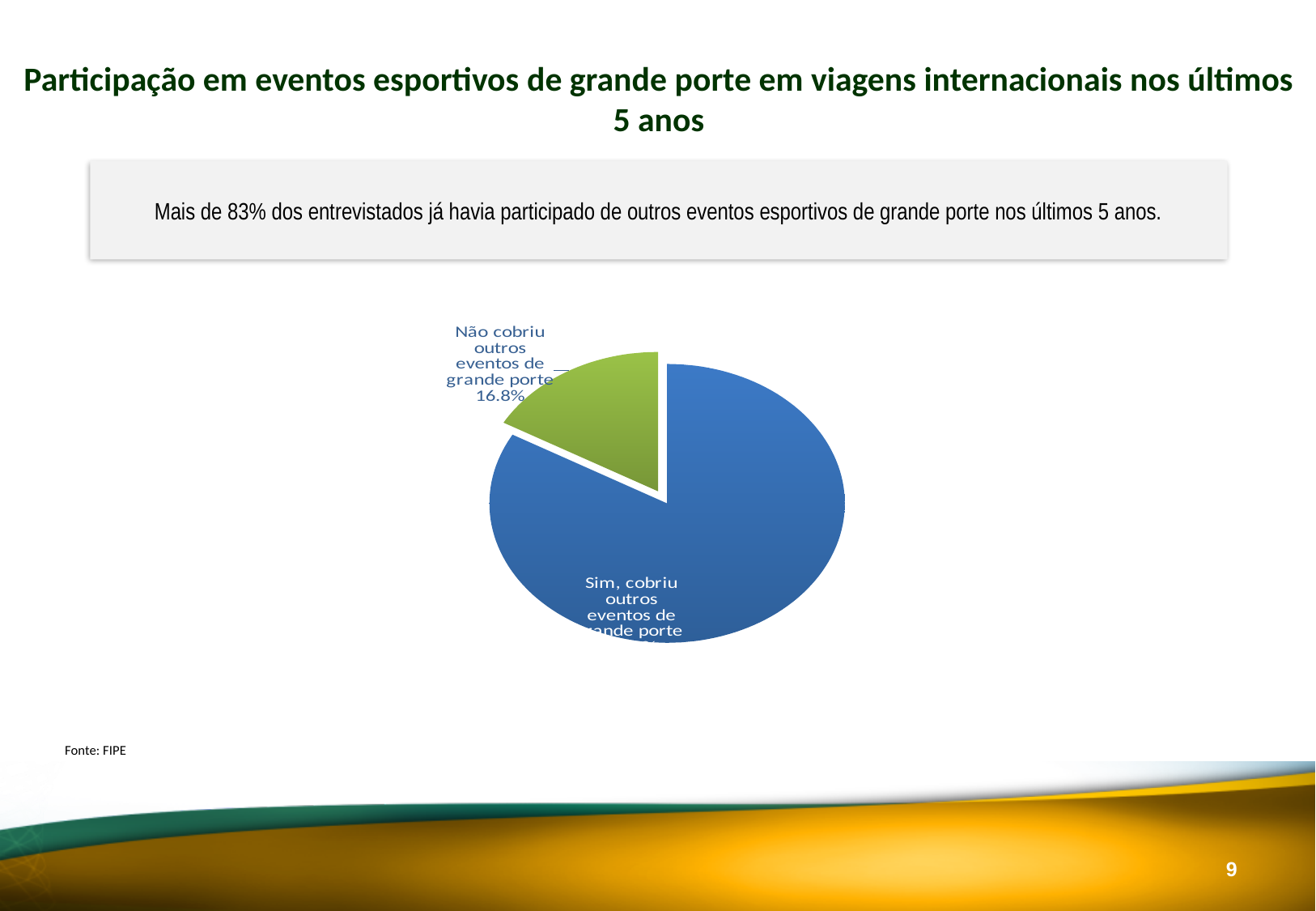
What source is cited for the chart on the slide? FIPE Which slice of the pie chart is the smallest? Não cobriu outros eventos de grande porte What share of the pie is labelled "Não cobriu outros eventos de grande porte"? 16.8% What colour is the "Não cobriu outros eventos de grande porte" slice? green How many slices does the pie chart have? 2 What kind of chart is shown on the slide? pie chart Which is larger: the "Sim, cobriu outros eventos de grande porte" slice or the "Não cobriu outros eventos de grande porte" slice? Sim, cobriu outros eventos de grande porte Which slice of the pie chart is the largest? Sim, cobriu outros eventos de grande porte